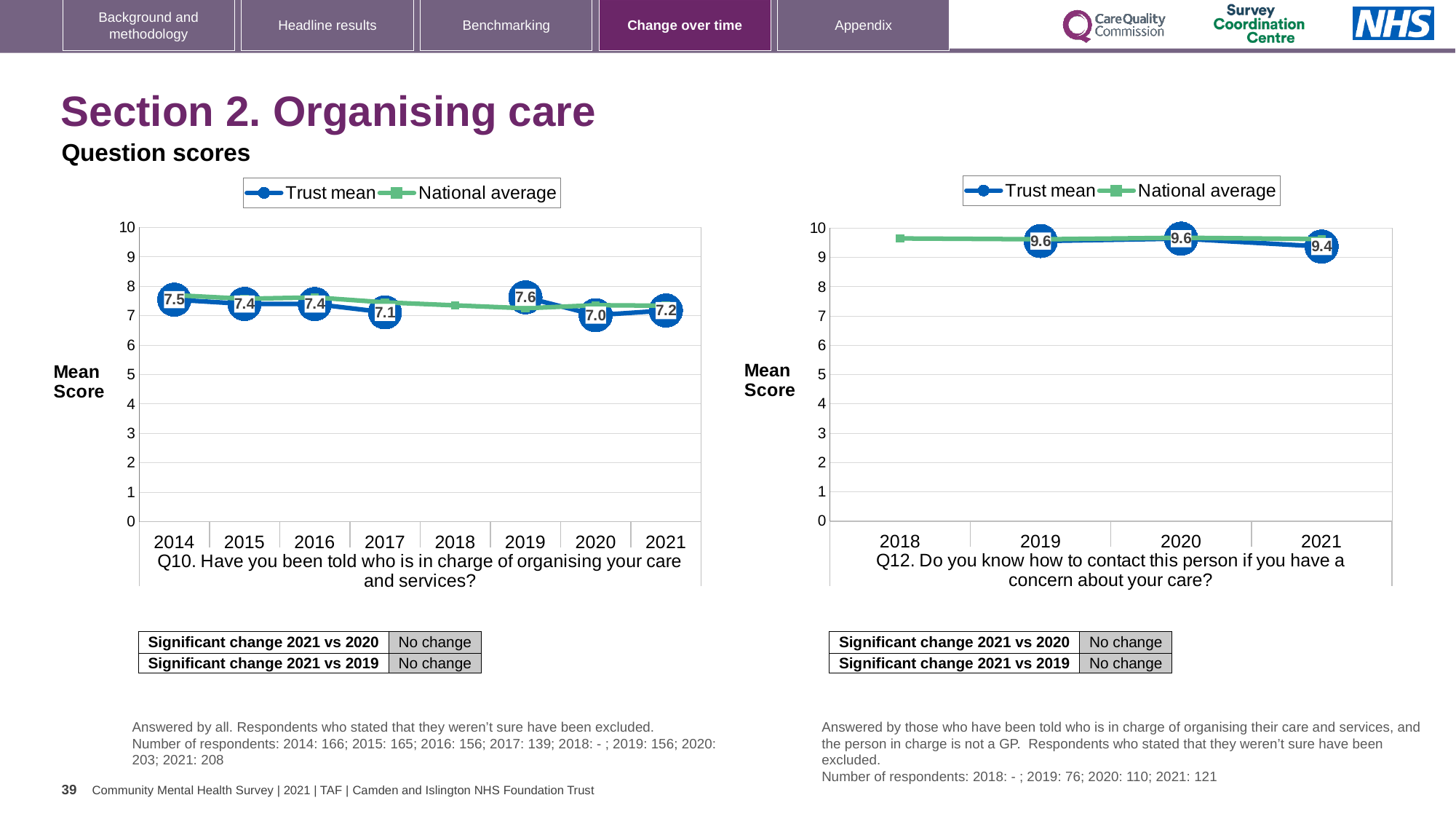
In the Q10 chart (left), what is the difference between the Trust mean in 2019 and in 2020? 0.6 In the Q10 chart (left), what is the Trust mean for 2014? 7.5 In the Q10 chart (left), how many years are shown on the x axis? 8 In the Q12 chart (right), what is the Trust mean for 2021? 9.4 What type of chart is used for the Q12 chart (right)? Line chart In the Q12 chart (right), what is the difference between the Trust mean in 2020 and in 2021? 0.2 In the Q10 chart (left), what is the Trust mean for 2021? 7.2 In the Q12 chart (right), how many series does the legend list? 2 In the Q10 chart (left), which year has the lowest Trust mean? 2020 In the Q10 chart (left), which year has the highest Trust mean? 2019 In the Q10 chart (left), is the Trust mean higher in 2017 or in 2021? 2021 In the Q12 chart (right), is the National average for 2018 greater or less than 9? greater